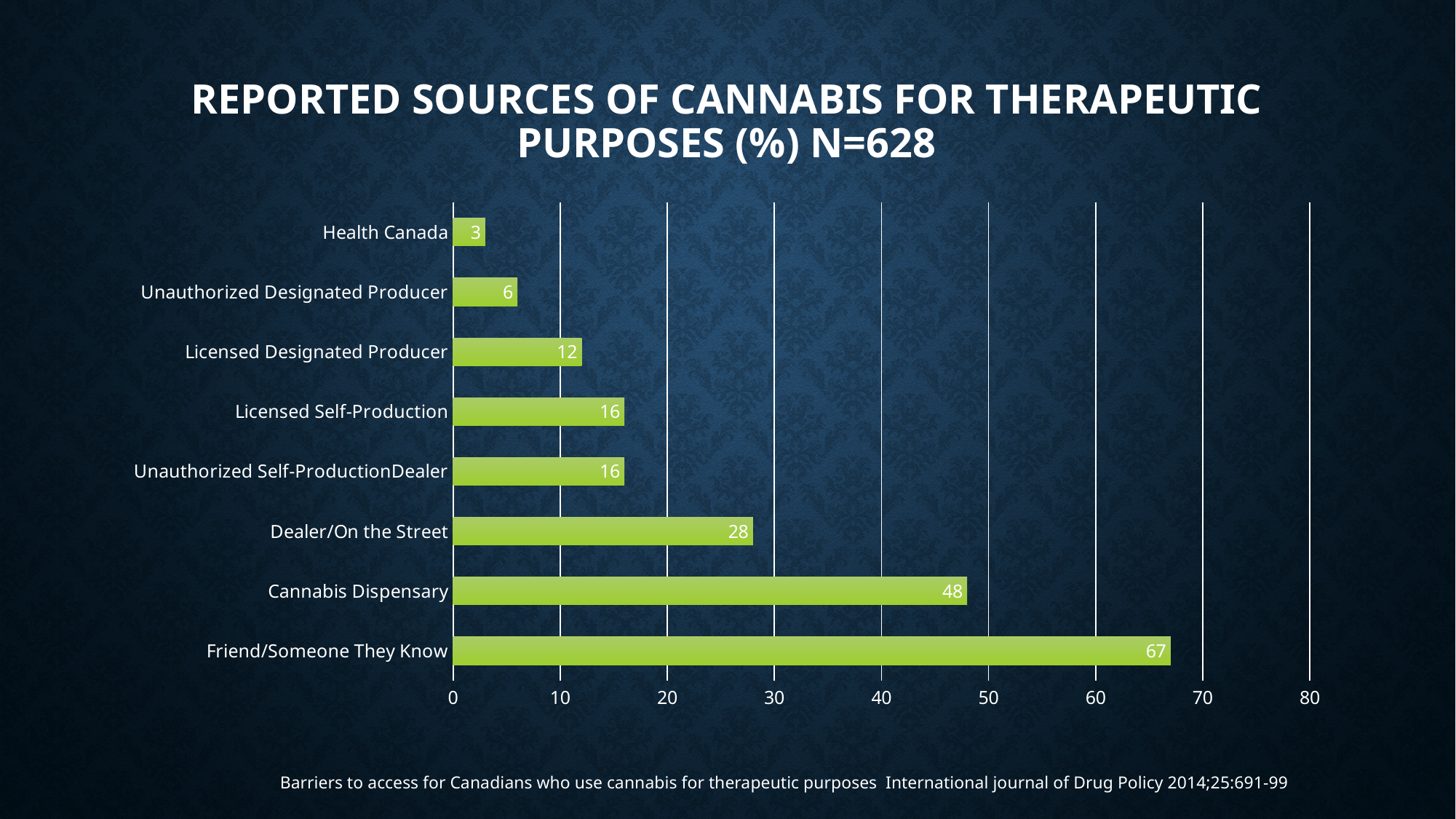
What is the difference between the values for Friend/Someone They Know and Cannabis Dispensary? 19 Is the value for Cannabis Dispensary greater or less than 40? greater How many sources are shown in the chart? 8 What kind of chart is shown on the slide? bar chart What is the value for Cannabis Dispensary? 48 What is the difference between the values for Licensed Designated Producer and Unauthorized Designated Producer? 6 Which source has the highest value? Friend/Someone They Know What is the value for Health Canada? 3 Which source has the lowest value? Health Canada What is the value for Dealer/On the Street? 28 What is the title of the chart? Reported Sources of Cannabis for Therapeutic Purposes (%) N=628 Which is larger, the value for Dealer/On the Street or the value for Licensed Self-Production? Dealer/On the Street